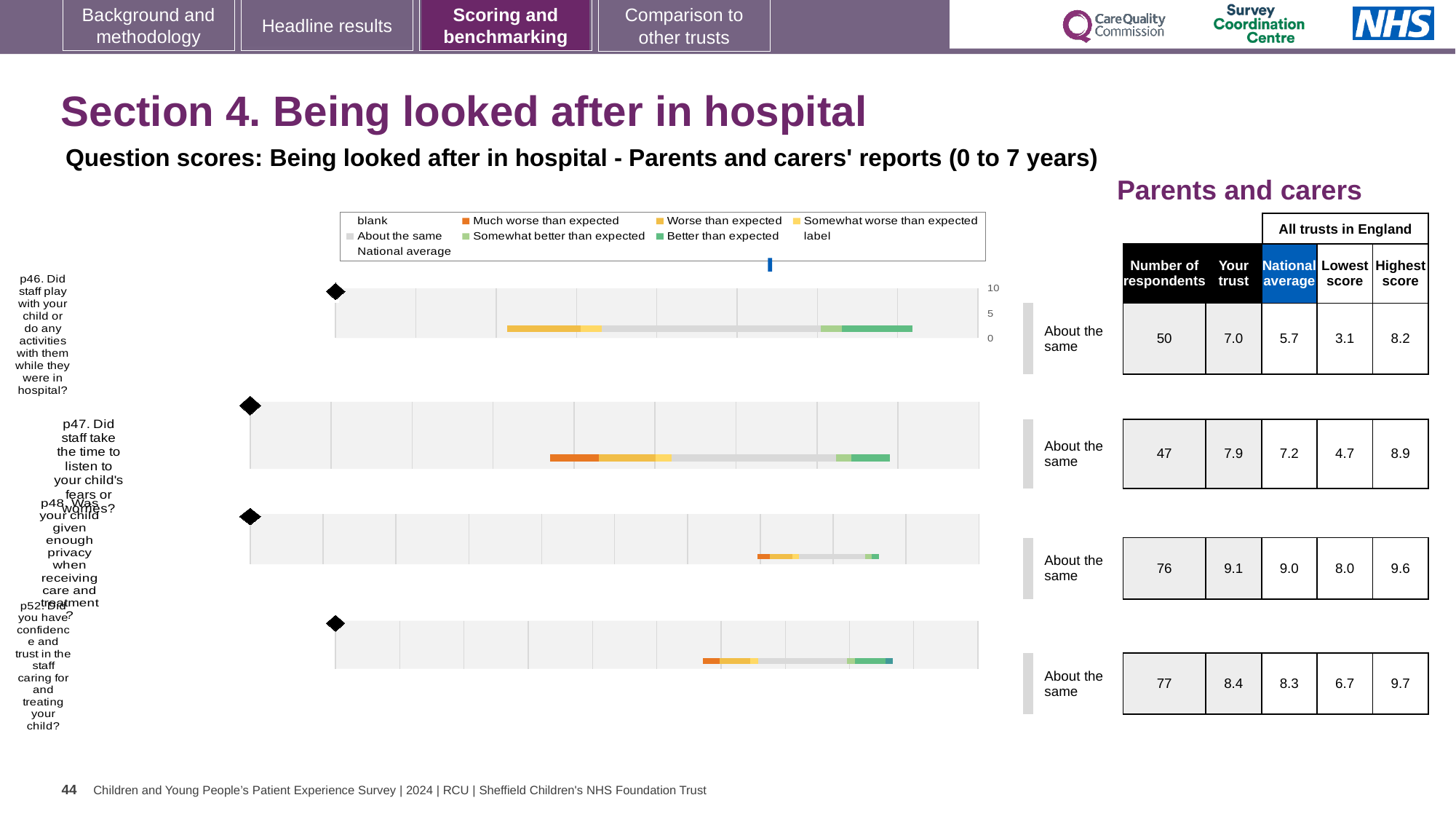
What is the highest score across all trusts in England for p52 (Did you have confidence and trust in the staff caring for and treating your child?)? 9.7 What kind of chart is used to show the question scores on this slide? bar chart Which question has the lowest 'Lowest score' across all trusts in England? p46 For p47, what is the difference between the 'Your trust' score and the national average? 0.7 What is the number of respondents for p46 (Did staff play with your child or do any activities with them while they were in hospital?)? 50 For p52, which is larger: the 'Your trust' score or the national average? Your trust How many questions (bars) are plotted on the slide? 4 Which colour in the legend represents 'Much worse than expected'? orange What is the national average score for p48 (Was your child given enough privacy when receiving care and treatment?)? 9.0 What is the 'Your trust' score for p47 (Did staff take the time to listen to your child's fears or worries?)? 7.9 Which question has the highest 'Your trust' score? p48 What benchmark category is shown for every question on this slide? About the same